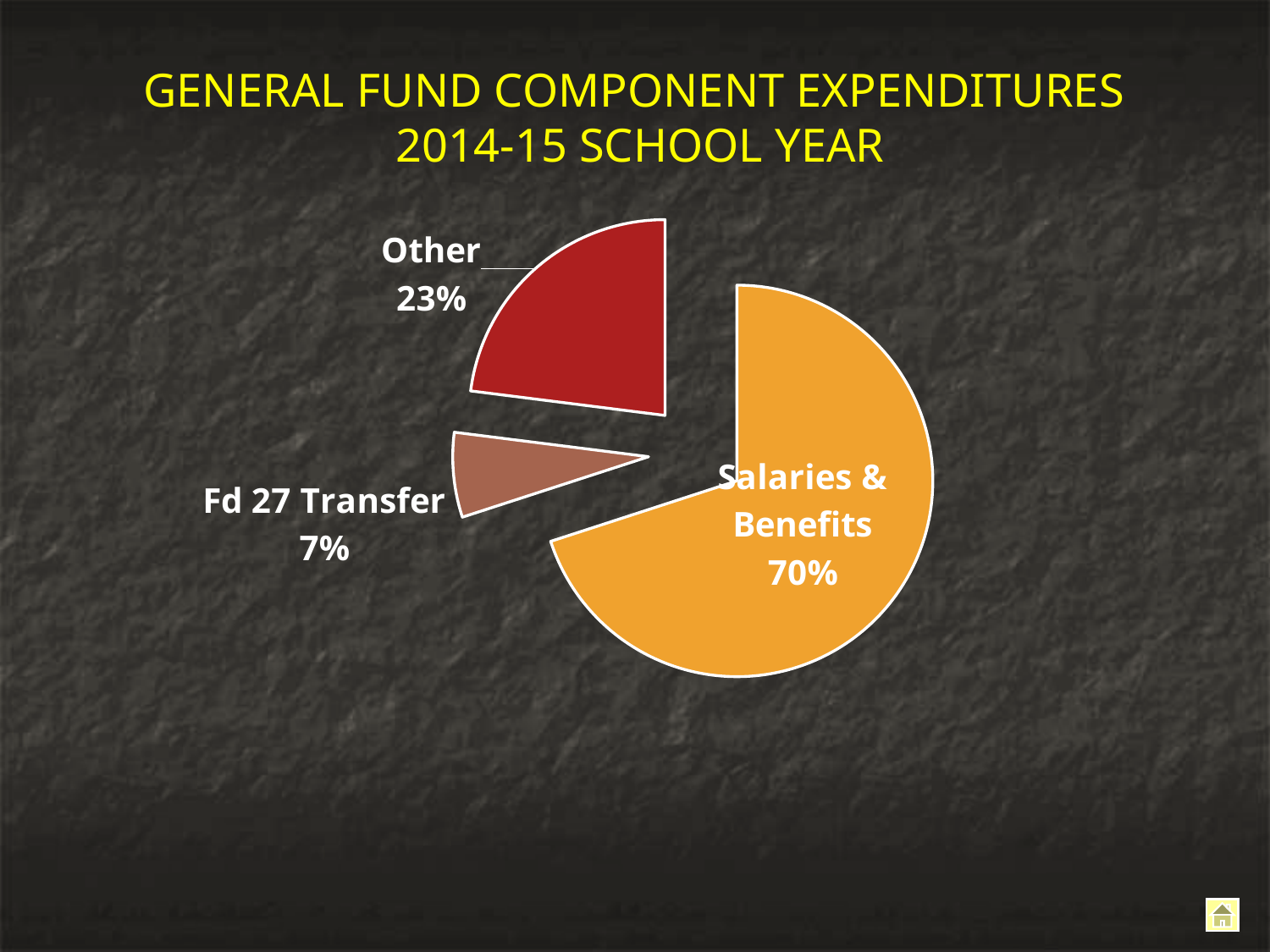
Which category has the smallest slice of the pie? Fd 27 Transfer What colour is the Salaries & Benefits slice? Orange What share of the pie is Other? 23% Which category has the largest slice of the pie? Salaries & Benefits What is the title of the slide containing the pie chart? GENERAL FUND COMPONENT EXPENDITURES 2014-15 SCHOOL YEAR What share of the pie is Salaries & Benefits? 70% How many slices does the pie chart have? 3 What is the difference in percentage points between Other and Fd 27 Transfer? 16 What share of the pie is Fd 27 Transfer? 7% What is the difference in percentage points between Salaries & Benefits and Other? 47 Which is larger, the share for Other or the share for Fd 27 Transfer? Other What kind of chart is shown on the slide? Pie chart